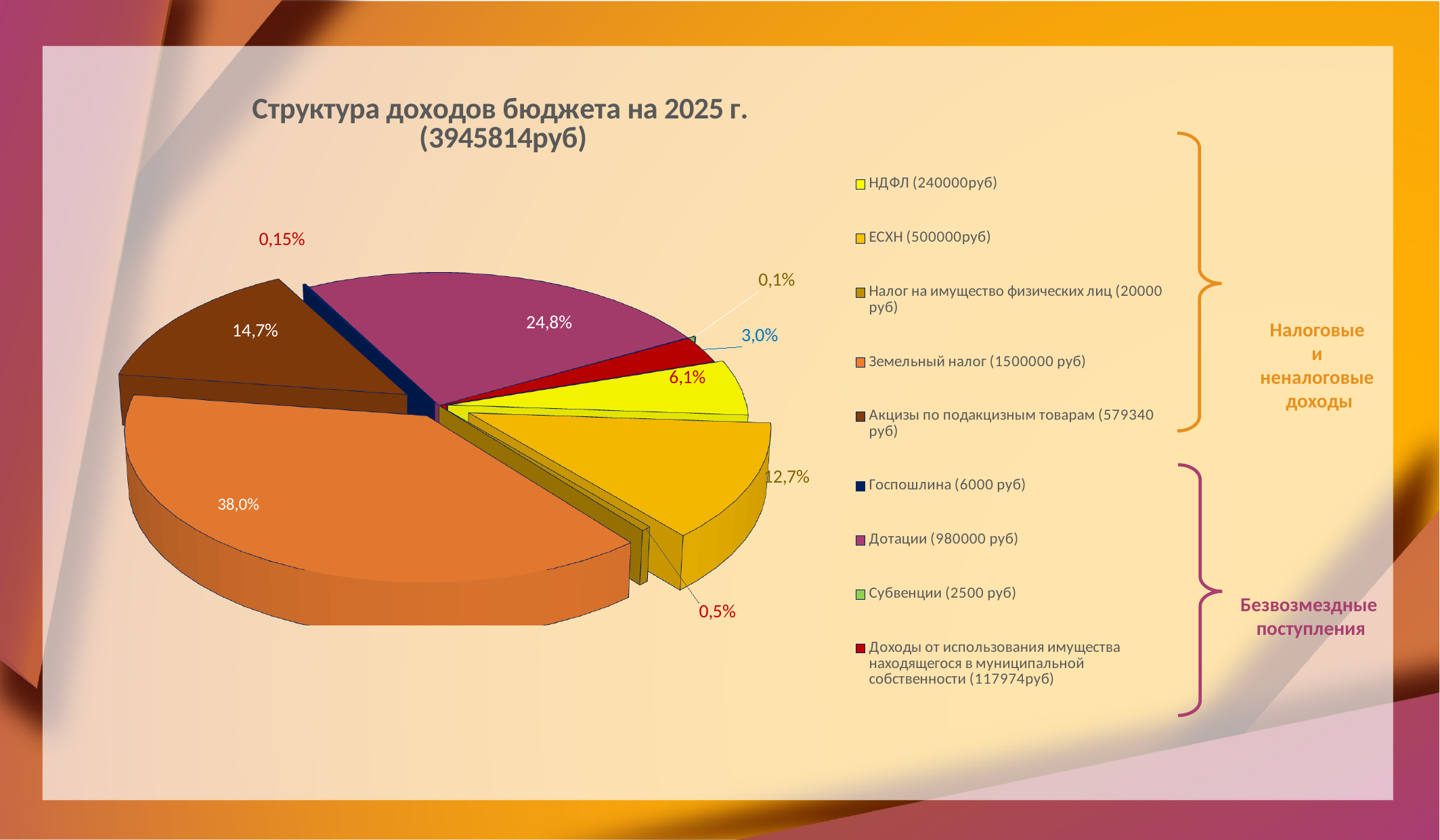
What share of the pie does НДФЛ take? 6,1% Which category has the largest slice of the pie? Земельный налог What amount in rubles is shown in the legend for Акцизы по подакцизным товарам? 579340 руб What share of the pie does ЕСХН take? 12,7% What amount in rubles is shown in the legend for Дотации? 980000 руб What is the title of the chart? Структура доходов бюджета на 2025 г. (3945814руб) How many categories does the legend of the pie chart list? 9 What share of the pie does Земельный налог take? 38,0% What kind of chart is shown on the slide? pie chart Which is larger, the share for Дотации or the share for ЕСХН? Дотации